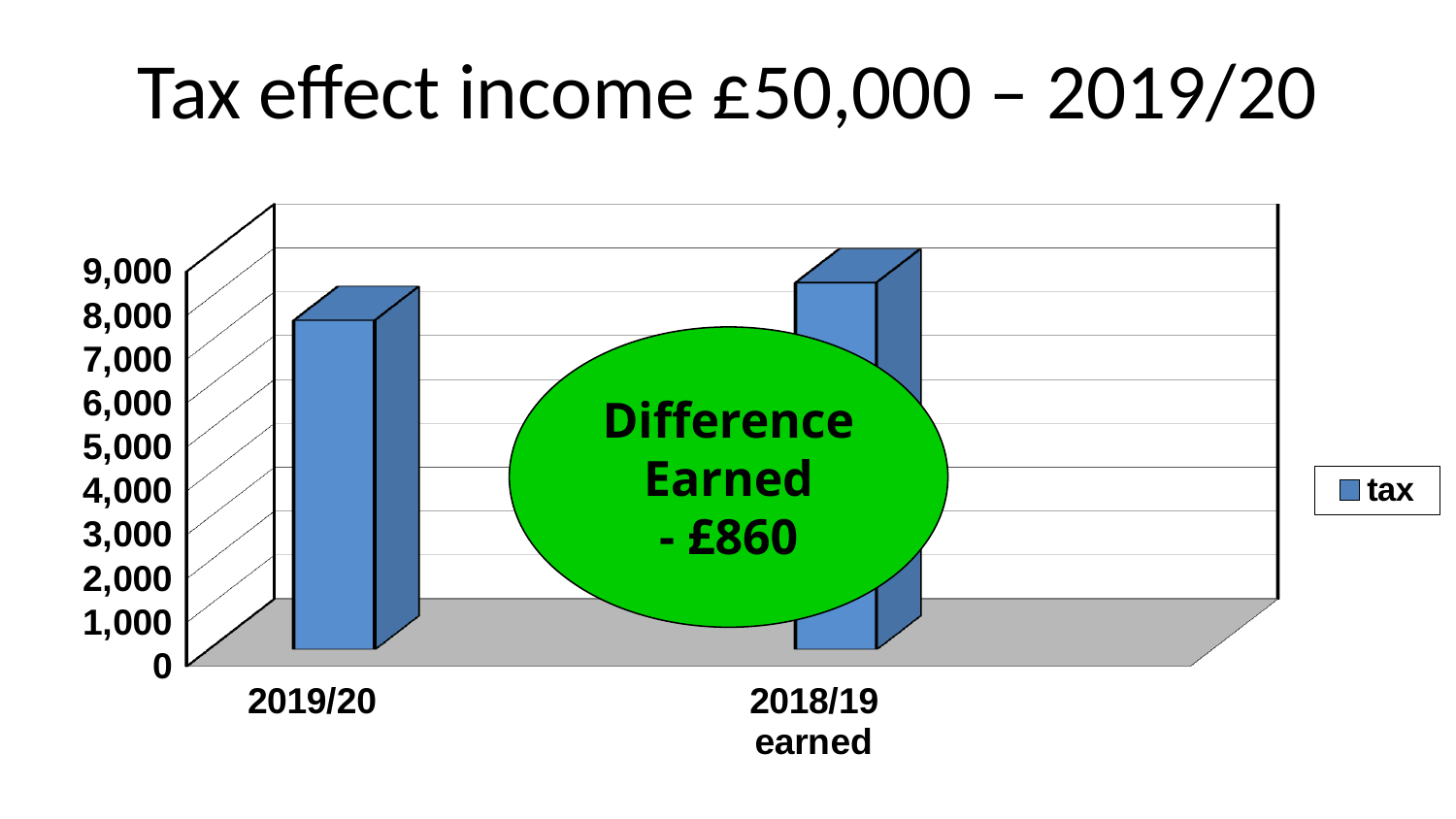
Which category has the highest bar? 2018/19 earned Which is larger, the bar for 2019/20 or the bar for 2018/19 earned? 2018/19 earned Do the bar values rise or fall moving along the x axis from 2019/20 to 2018/19 earned? rise What type of chart is shown on the slide? bar chart What series name appears in the legend? tax Is the value for 2019/20 greater or less than 9,000? less Is the value for 2019/20 greater or less than 6,000? greater What is the title of the slide? Tax effect income £50,000 – 2019/20 Is the value for 2018/19 earned greater or less than 7,000? greater How many series does the legend list? 1 Which category has the lowest bar? 2019/20 How many categories are shown on the x axis of the chart? 2